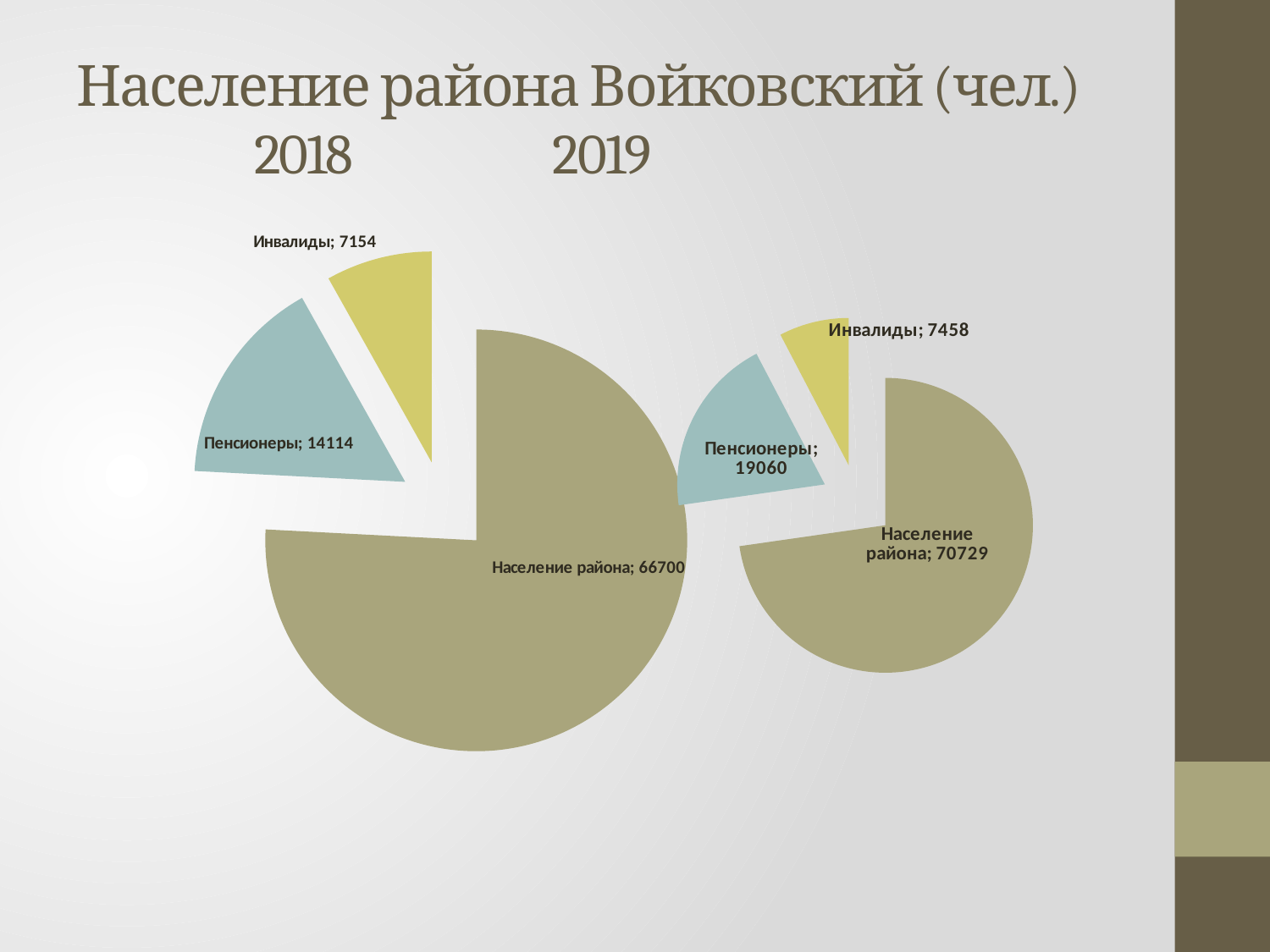
In the 2019 chart, what is the difference between Население района and Пенсионеры? 51669 What is the title of the slide containing the charts? Население района Войковский (чел.) What type of charts are shown on the slide? Pie charts In the 2018 chart, what is the value for Пенсионеры? 14114 In the 2019 chart, what is the value for Население района? 70729 How many slices does the 2019 chart have? 3 In the 2019 chart, which category has the smallest slice? Инвалиды In the 2018 chart, what is the difference between Пенсионеры and Инвалиды? 6960 In the 2019 chart, what is the value for Пенсионеры? 19060 In the 2018 chart, which category has the largest slice? Население района In the 2018 chart, what is the value for Инвалиды? 7154 Is the value for Пенсионеры larger in the 2018 chart or the 2019 chart? 2019